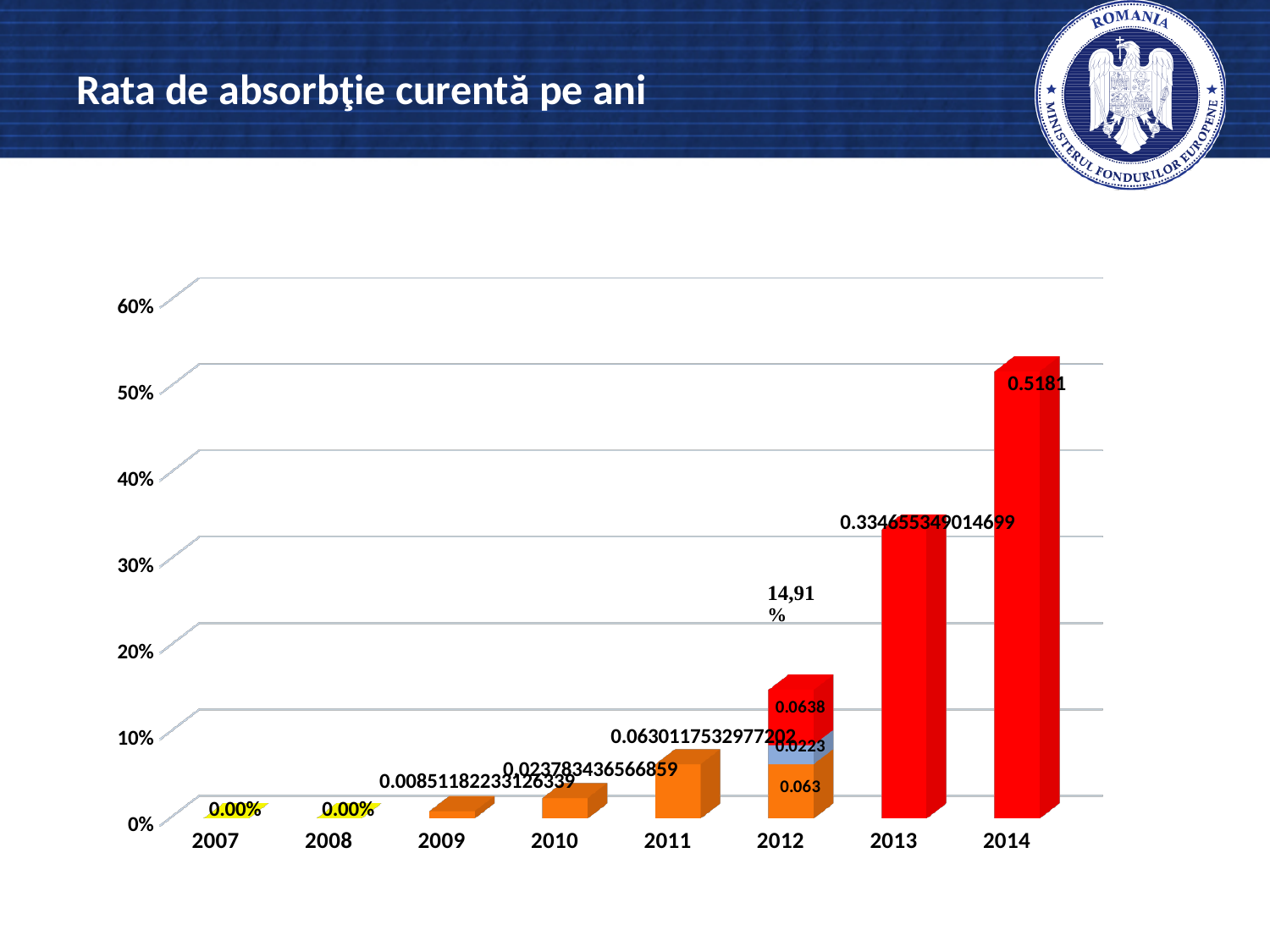
What is the value labelled for 2011? 0.0630117532977202 Is the value for 2013 greater or less than 30%? greater What is the value labelled for 2013? 0.334655349014699 Do the values generally rise or fall from 2007 to 2014? rise Which year has the highest bar? 2014 What is the value labelled for 2007? 0.00% What is the title of the chart? Rata de absorbţie curentă pe ani What kind of chart is shown on the slide? bar chart What is the value labelled for 2014? 0.5181 How many years are shown on the x axis of the chart? 8 What is the value labelled for 2009? 0.00851182233126339 Which is larger, the value for 2013 or the value for 2011? 2013